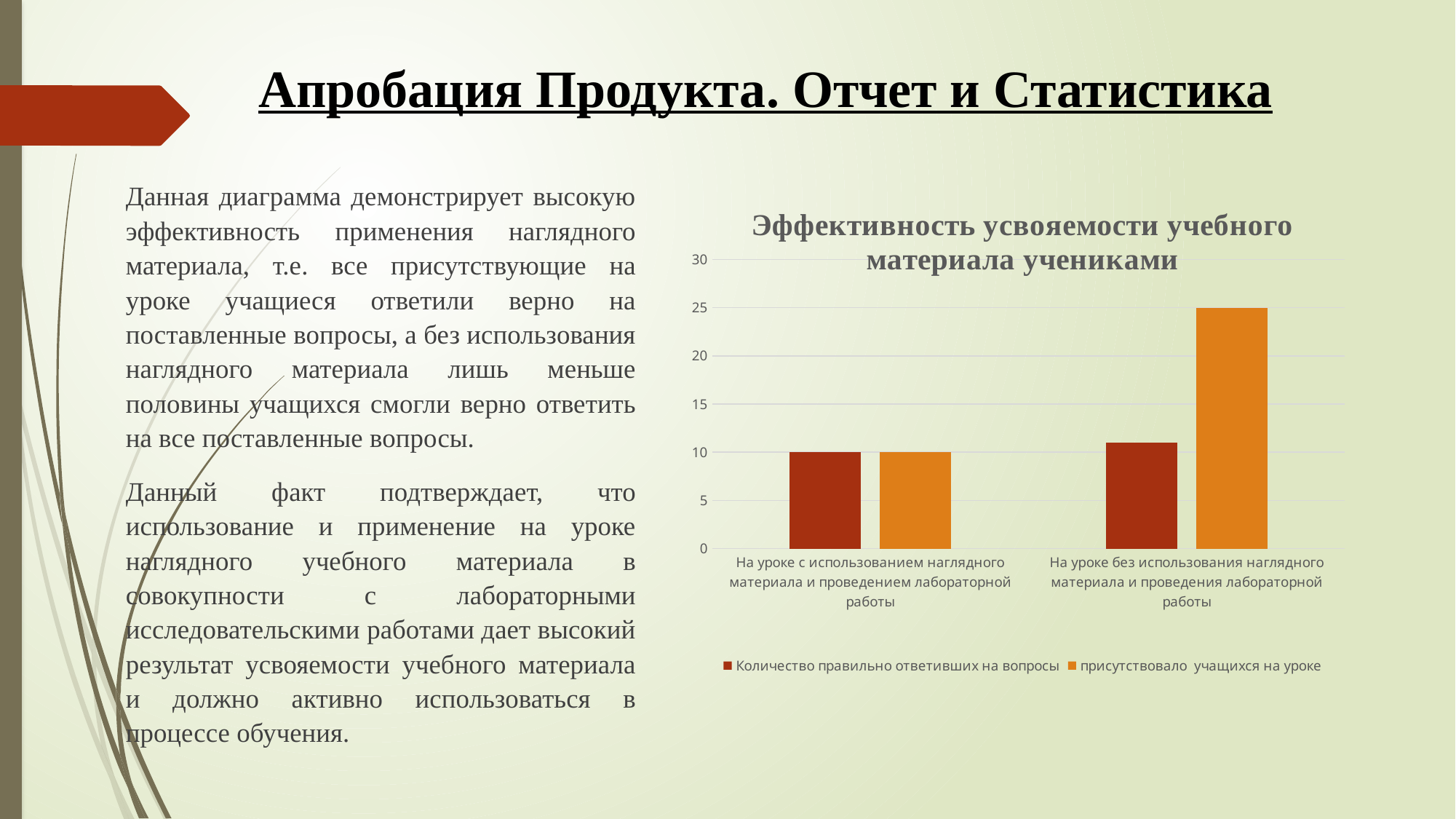
Which colour represents the series 'присутствовало учащихся на уроке' in the chart? orange How many categories are shown on the x axis of the chart? 2 What is the difference between the 'присутствовало учащихся на уроке' values of the two categories? 15 What is the title of the chart? Эффективность усвояемости учебного материала учениками What kind of chart is shown on the slide? bar chart Is the value of 'Количество правильно ответивших на вопросы' for the category 'На уроке без использования наглядного материала и проведения лабораторной работы' greater or less than 15? less What is the value of 'Количество правильно ответивших на вопросы' for the category 'На уроке с использованием наглядного материала и проведением лабораторной работы'? 10 How many series does the chart legend list? 2 In the category 'На уроке без использования наглядного материала и проведения лабораторной работы', which series has the larger value: 'Количество правильно ответивших на вопросы' or 'присутствовало учащихся на уроке'? присутствовало учащихся на уроке What is the value of 'присутствовало учащихся на уроке' for the category 'На уроке без использования наглядного материала и проведения лабораторной работы'? 25 What is the value of 'присутствовало учащихся на уроке' for the category 'На уроке с использованием наглядного материала и проведением лабораторной работы'? 10 Which category has the highest value for 'присутствовало учащихся на уроке'? На уроке без использования наглядного материала и проведения лабораторной работы